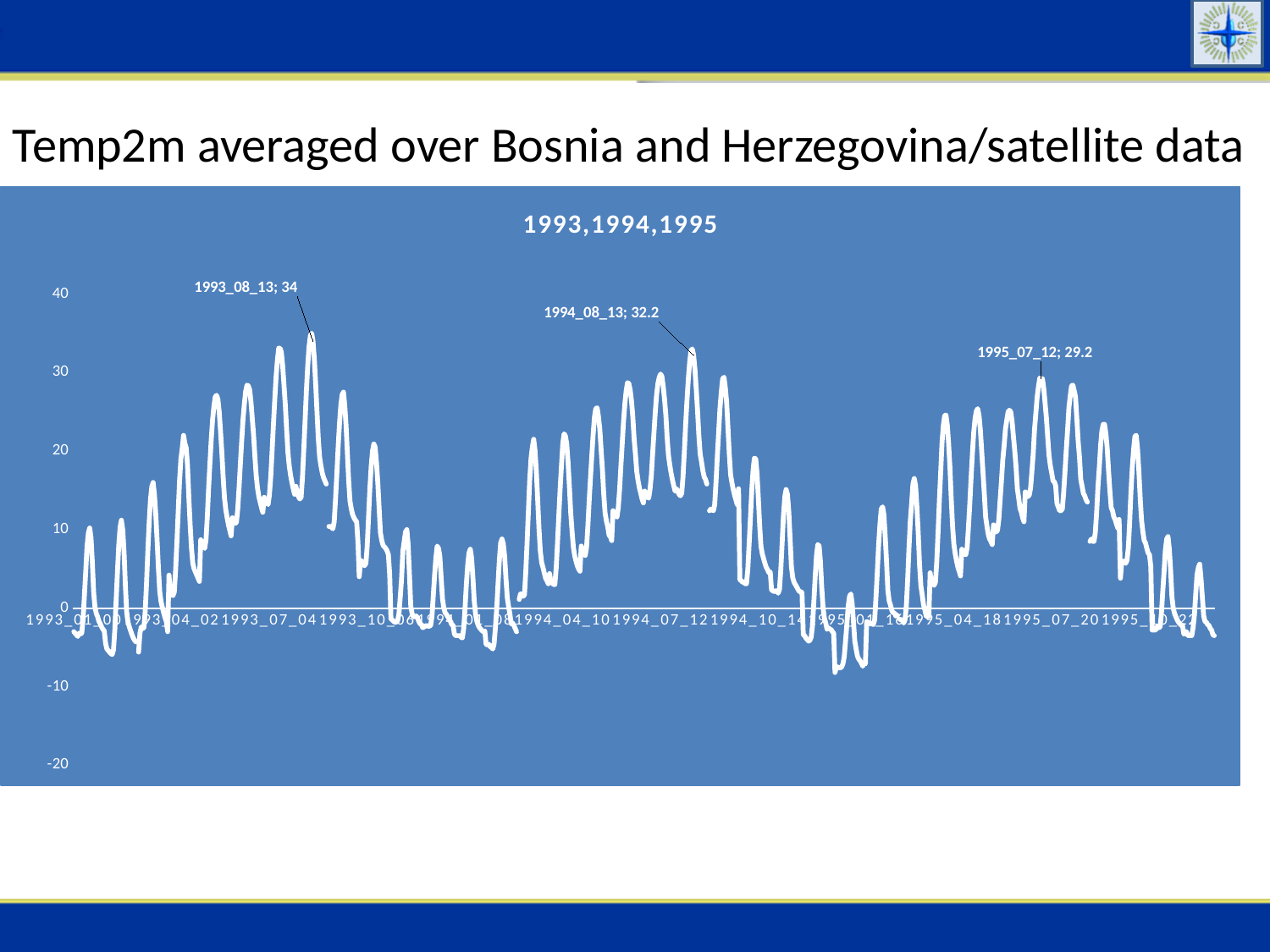
What is the difference between the labelled values at 1993_08_13 and 1994_08_13? 1.8 Which is larger, the labelled value at 1993_08_13 or at 1995_07_12? 1993_08_13 What is the difference between the labelled values at 1994_08_13 and 1995_07_12? 3 What is the labelled value at 1994_08_13? 32.2 Which of the three labelled peaks has the lowest value? 1995_07_12 What is the title of the chart? 1993,1994,1995 How many data points have value labels on the chart? 3 What type of chart is shown on the slide? line chart Which of the three labelled peaks has the highest value? 1993_08_13 What is the labelled value at 1993_08_13? 34 What is the highest value shown on the vertical axis? 40 What is the labelled value at 1995_07_12? 29.2